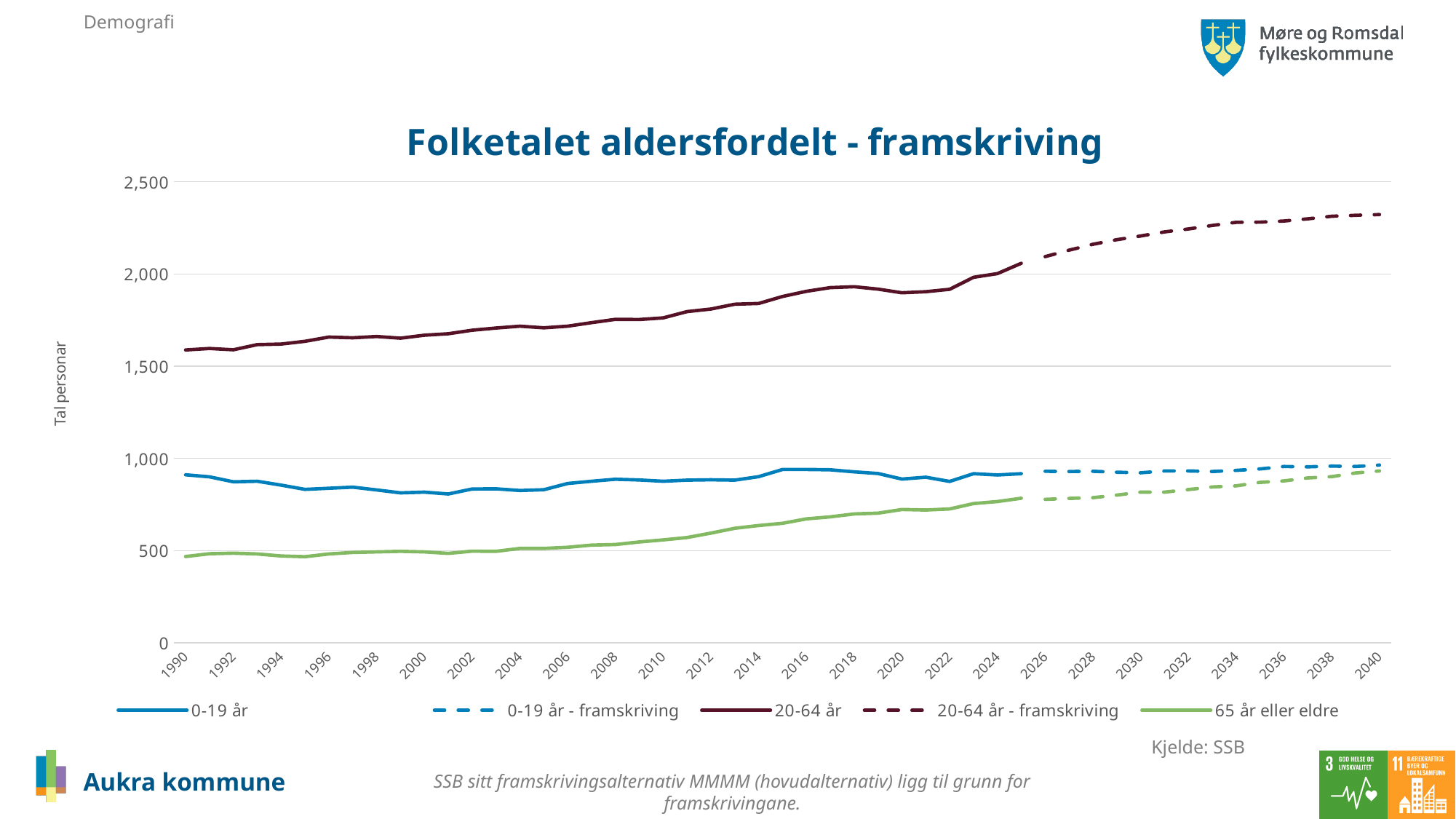
Is the value for 0-19 år in 2016 greater or less than 1,000? less Is the value for 20-64 år - framskriving in 2040 greater or less than 2,000? greater Which series has the highest value in 2010? 20-64 år How many series does the chart legend list? 5 Is the value for 20-64 år in 1990 greater or less than 1,500? greater What is the title of the chart? Folketalet aldersfordelt - framskriving Does the 65 år eller eldre line rise or fall from 1990 to 2024? rise In 2000, which is larger: the value for 0-19 år or the value for 65 år eller eldre? 0-19 år What is the label on the vertical axis? Tal personar What kind of chart is shown on the slide? line chart